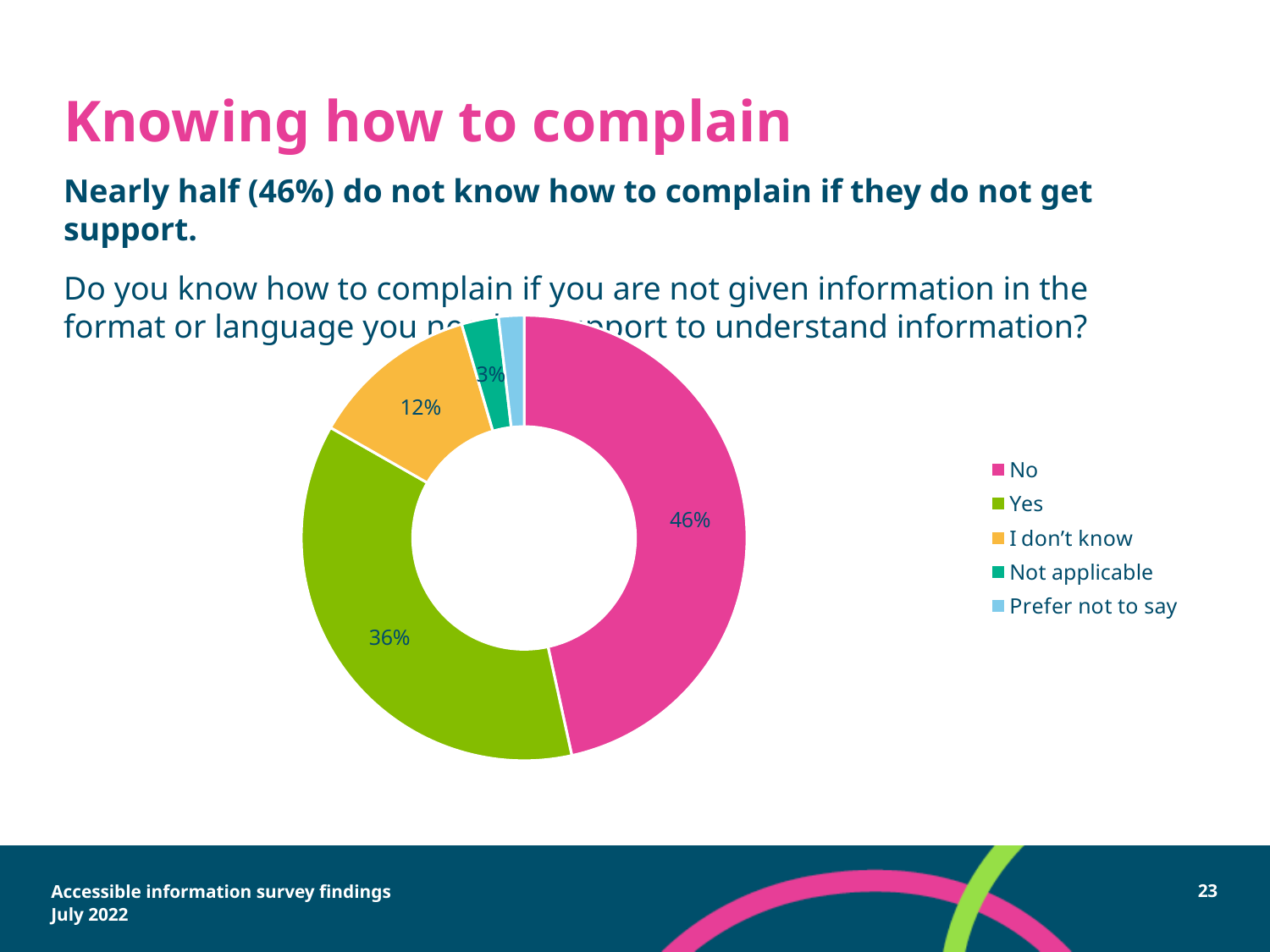
Which response has the largest share of the chart? No What percentage of respondents answered "No"? 46% How many response categories does the chart show? 5 What percentage of respondents answered "Yes"? 36% Which response has the smallest share of the chart? Prefer not to say What percentage of respondents answered "I don't know"? 12% What colour represents the "No" response in the chart? Pink Which is larger, the share for "Yes" or the share for "I don't know"? Yes What share of the chart does the "No" slice represent? 46% Which legend entry is listed last? Prefer not to say What is the difference in percentage points between the "No" and "Yes" responses? 10 percentage points What kind of chart is shown on the slide? Doughnut (pie) chart